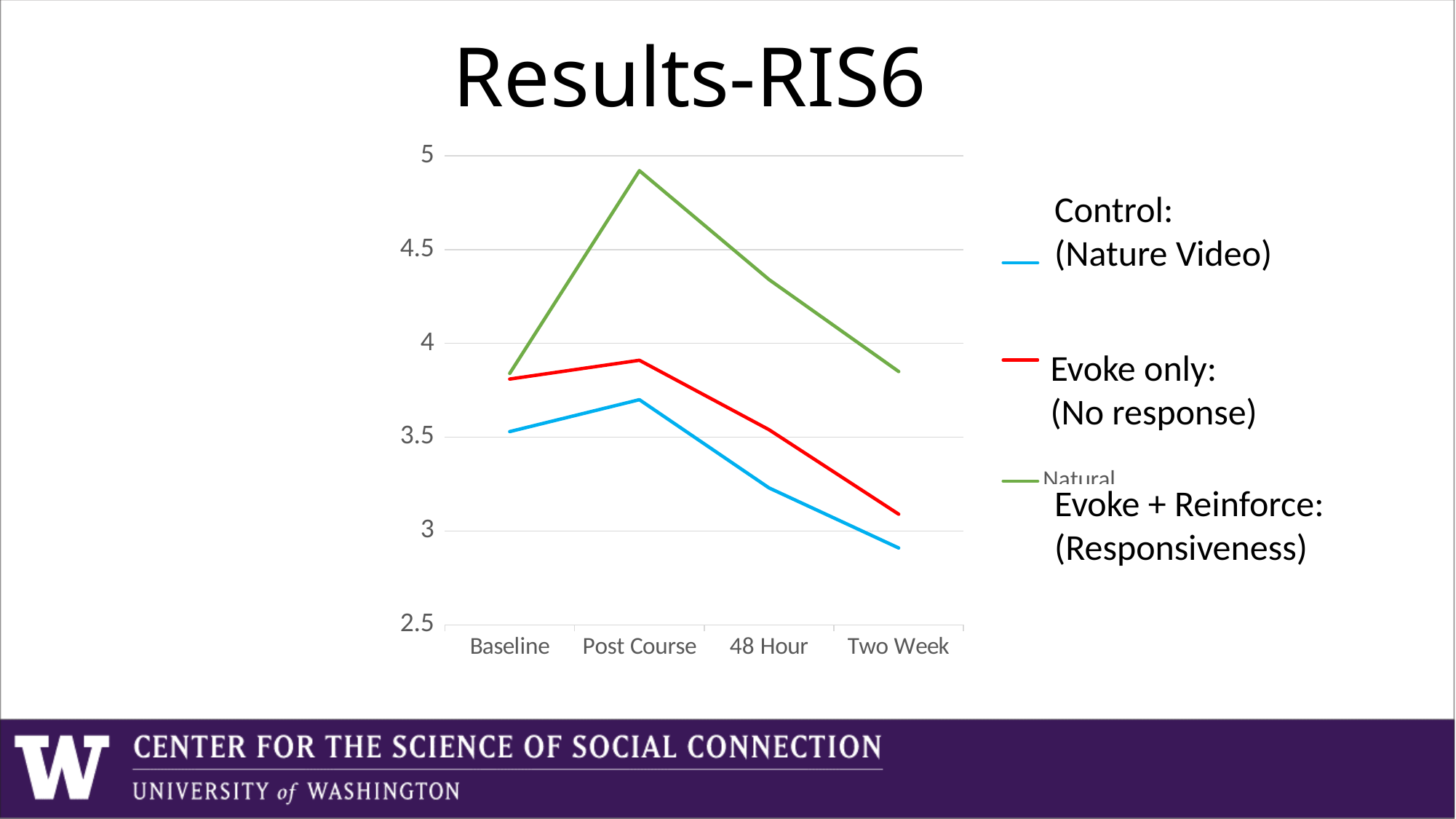
What kind of chart is shown on the slide? line chart At which time point is the Control (Nature Video) line at its lowest value? Two Week Is the value for Control (Nature Video) at Two Week greater or less than 3? less How many time points are shown on the x axis? 4 Is the value for Control (Nature Video) at 48 Hour greater or less than 3.5? less At Post Course, which is larger: the Evoke + Reinforce (Responsiveness) value or the Control (Nature Video) value? Evoke + Reinforce (Responsiveness) How many series does the chart plot? 3 Is the value for Evoke only (No response) at Baseline greater or less than 4? less Do the lines rise or fall from Post Course to Two Week? fall At which time point does the Evoke + Reinforce (Responsiveness) line reach its highest value? Post Course Which colour is used for the Evoke only (No response) line? red